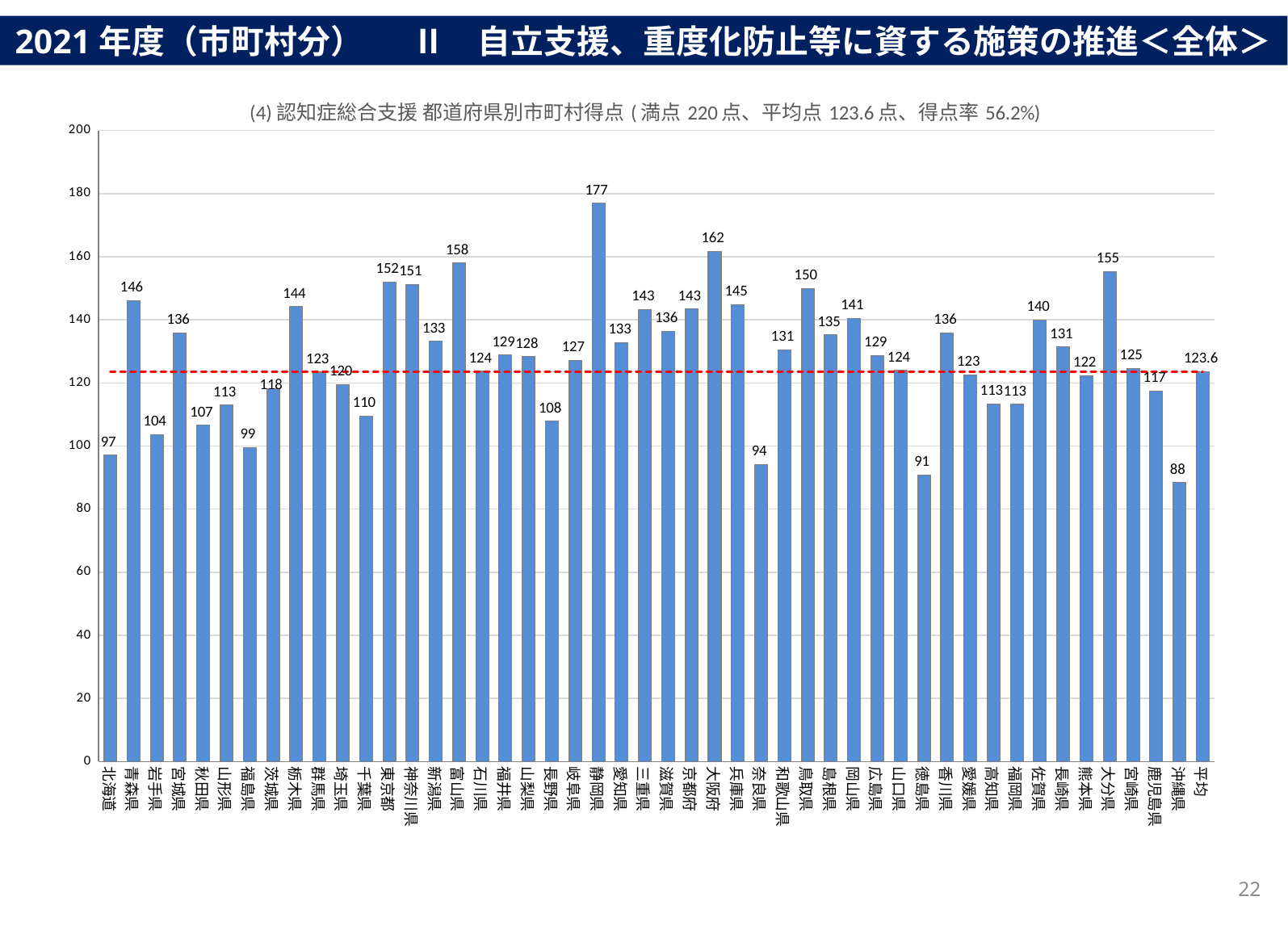
What kind of chart is shown on the slide? bar chart Which prefecture has the highest value? 静岡県 Which is larger, the value for 富山県 or the value for 大分県? 富山県 What is the value for 静岡県? 177 What is the value shown for 平均? 123.6 What is the value for 沖縄県? 88 What is the difference between the values for 静岡県 and 沖縄県? 89 What is the difference between the values for 東京都 and 神奈川県? 1 What is the value for 大阪府? 162 Which prefecture has the lowest value? 沖縄県 How many bars are plotted in the chart? 48 Is the value for 奈良県 greater or less than 100? less